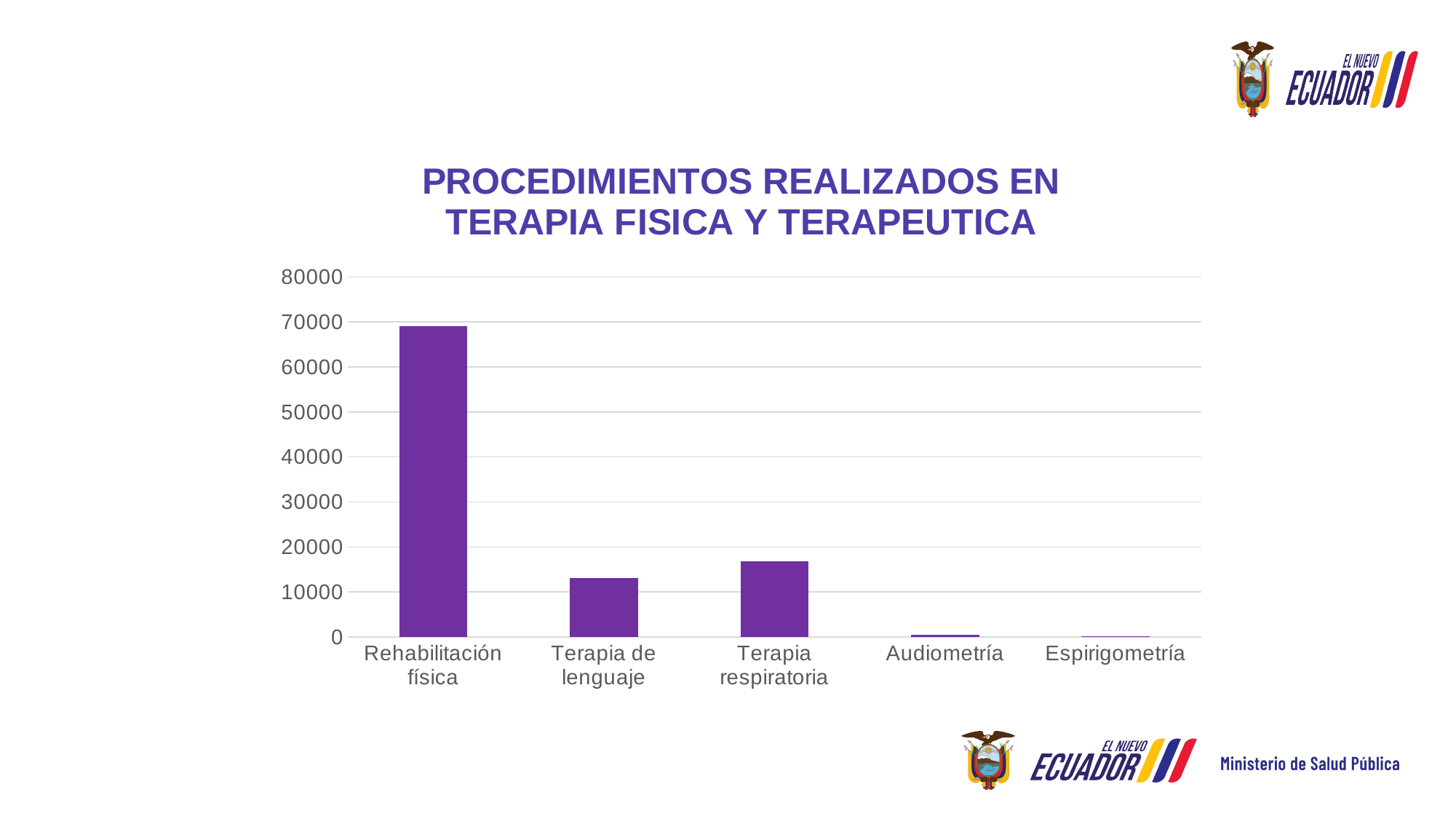
What is the title of the chart? PROCEDIMIENTOS REALIZADOS EN TERAPIA FISICA Y TERAPEUTICA Which category has the highest value in the chart? Rehabilitación física How many categories are shown on the x axis of the chart? 5 Is the value for Rehabilitación física greater or less than 60000? greater What kind of chart is shown on the slide? bar chart Is the value for Audiometría greater or less than 10000? less Is the value for Terapia respiratoria greater or less than 20000? less Which is larger, the value for Terapia respiratoria or the value for Terapia de lenguaje? Terapia respiratoria What colour are the bars in the chart? purple Which is larger, the value for Rehabilitación física or the value for Terapia respiratoria? Rehabilitación física